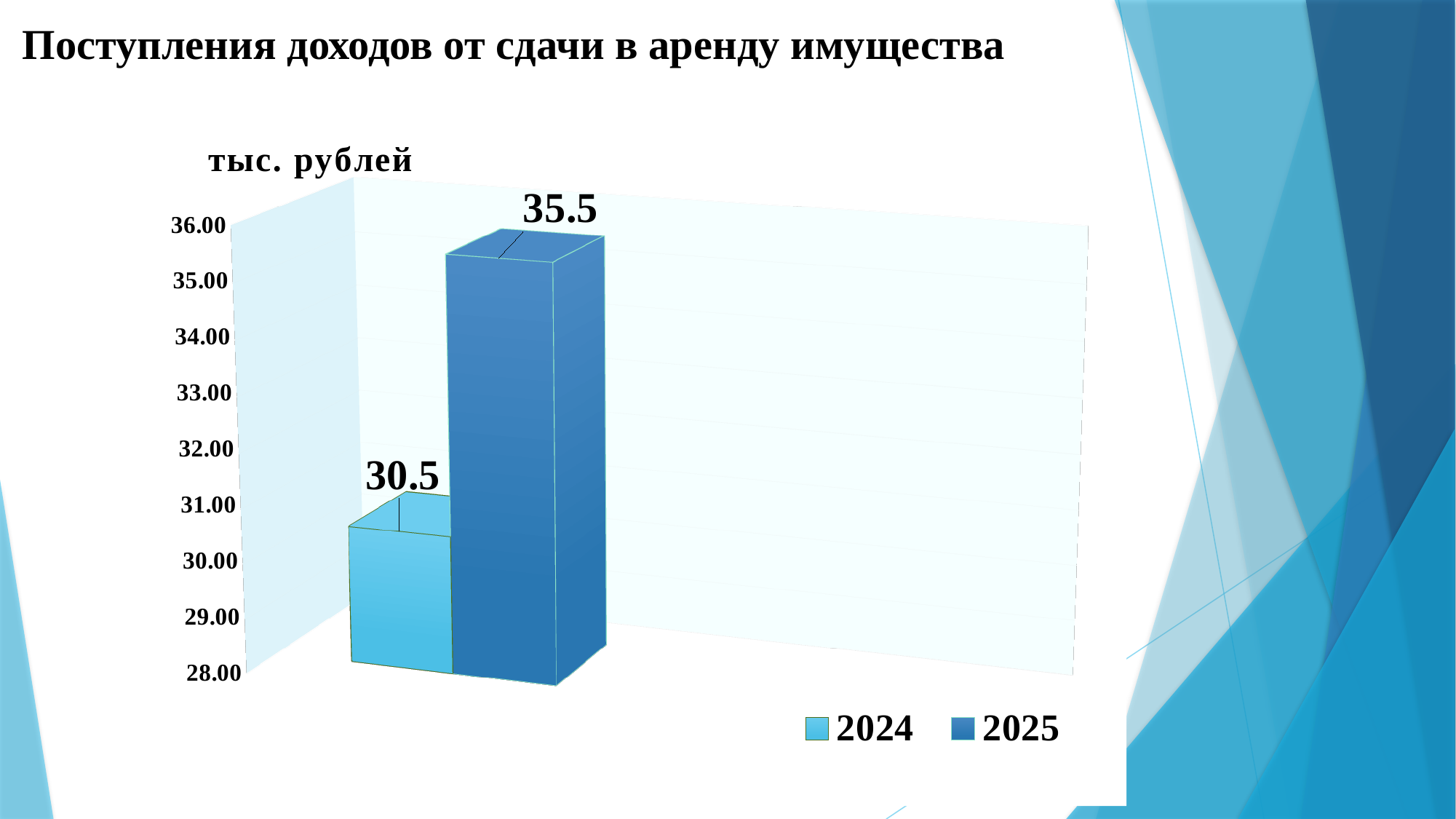
Is the value for 2025 greater or less than 34.00? greater Do the values rise or fall from 2024 to 2025? Rise What is the difference between the 2025 and 2024 values? 5 Is the value for 2025 larger than the value for 2024? Yes What is the value for 2024? 30.5 What kind of chart is shown on the slide? Bar chart How many series does the legend list? 2 Which year has the lower value? 2024 What is the value for 2025? 35.5 What unit is shown above the chart's vertical axis? тыс. рублей Which year has the higher value? 2025 Is the value for 2024 greater or less than 32.00? less